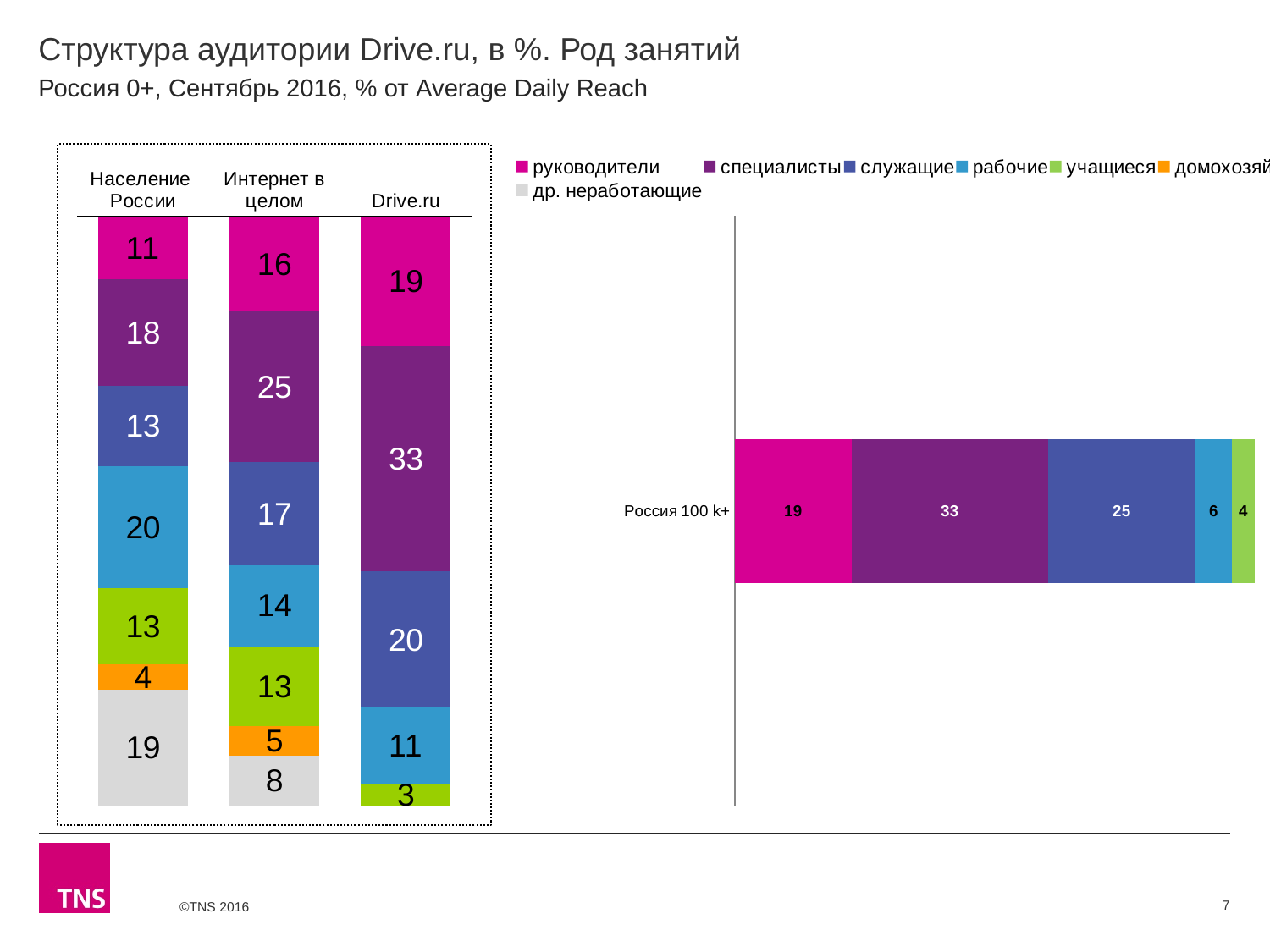
In the left chart, what is the difference between the руководители values for Drive.ru and Население России? 8 In the right chart, what is the value for служащие (blue) in the Россия 100 k+ bar? 25 In the left chart, what is the value for специалисты (purple) in the Drive.ru bar? 33 In the left chart, what is the value for руководители (pink) in the Население России bar? 11 In the left chart, is the служащие value larger for Drive.ru or for Интернет в целом? Drive.ru In the left chart, which of the three bars has the highest value for специалисты (purple)? Drive.ru What type of chart is the chart on the right? Stacked bar chart How many bars (categories) does the left chart show? 3 In the left chart, which of the three bars has the lowest value for учащиеся (green)? Drive.ru How many series does the legend on the right list? 7 In the right chart, what is the total of the labelled segments in the Россия 100 k+ bar? 87 In the left chart, what is the value for рабочие (light blue) in the Интернет в целом bar? 14